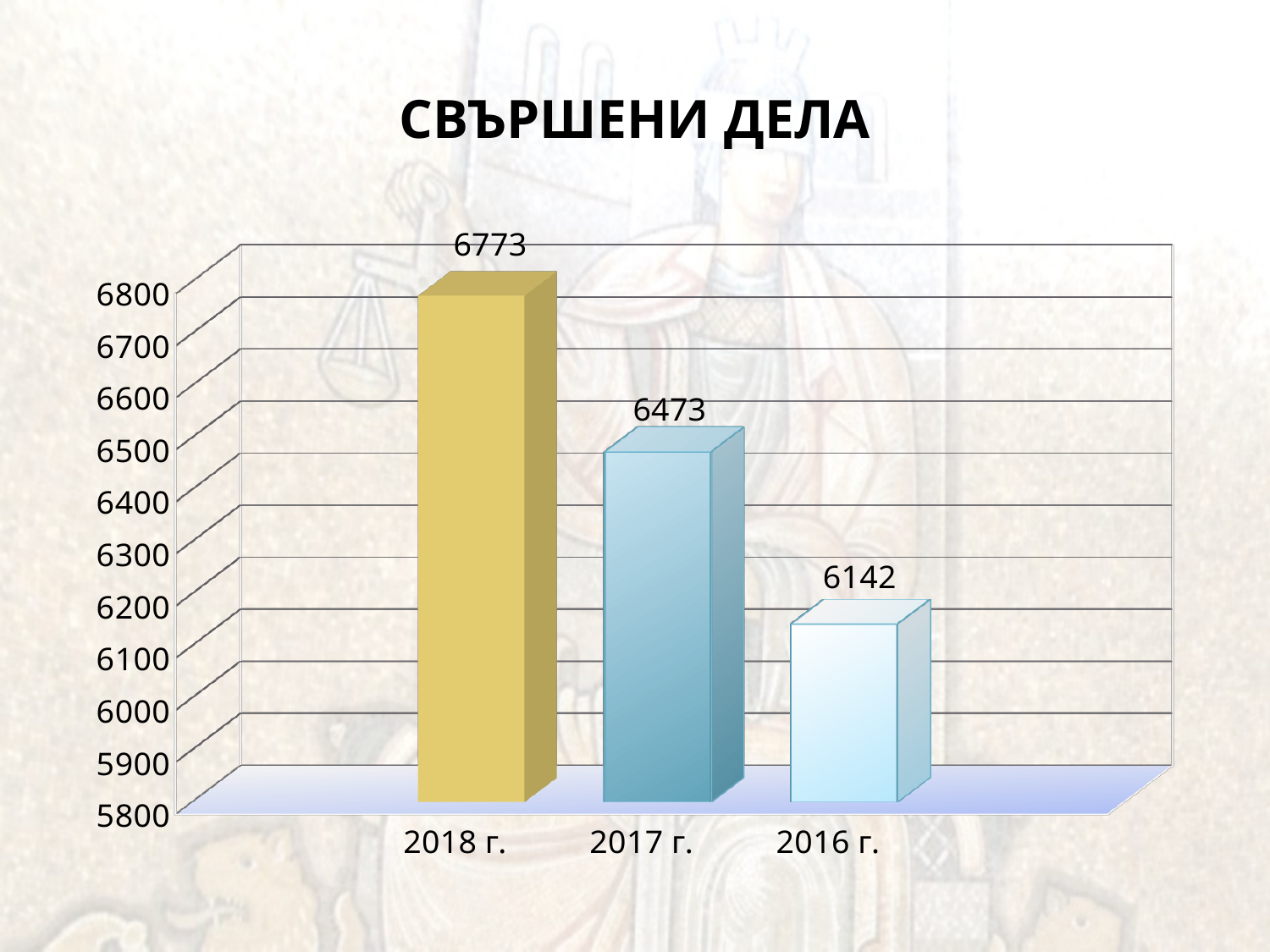
What is the value for 2017 г.? 6473 What kind of chart is shown on the slide? bar chart What is the difference between the values for 2018 г. and 2017 г.? 300 What is the title of the chart? СВЪРШЕНИ ДЕЛА What is the value for 2018 г.? 6773 What is the difference between the values for 2017 г. and 2016 г.? 331 What is the value for 2016 г.? 6142 Which is larger, the value for 2017 г. or the value for 2016 г.? 2017 г. Which year has the highest value? 2018 г. How many categories are shown on the chart? 3 Is the value for 2016 г. greater or less than 6200? less Which year has the lowest value? 2016 г.